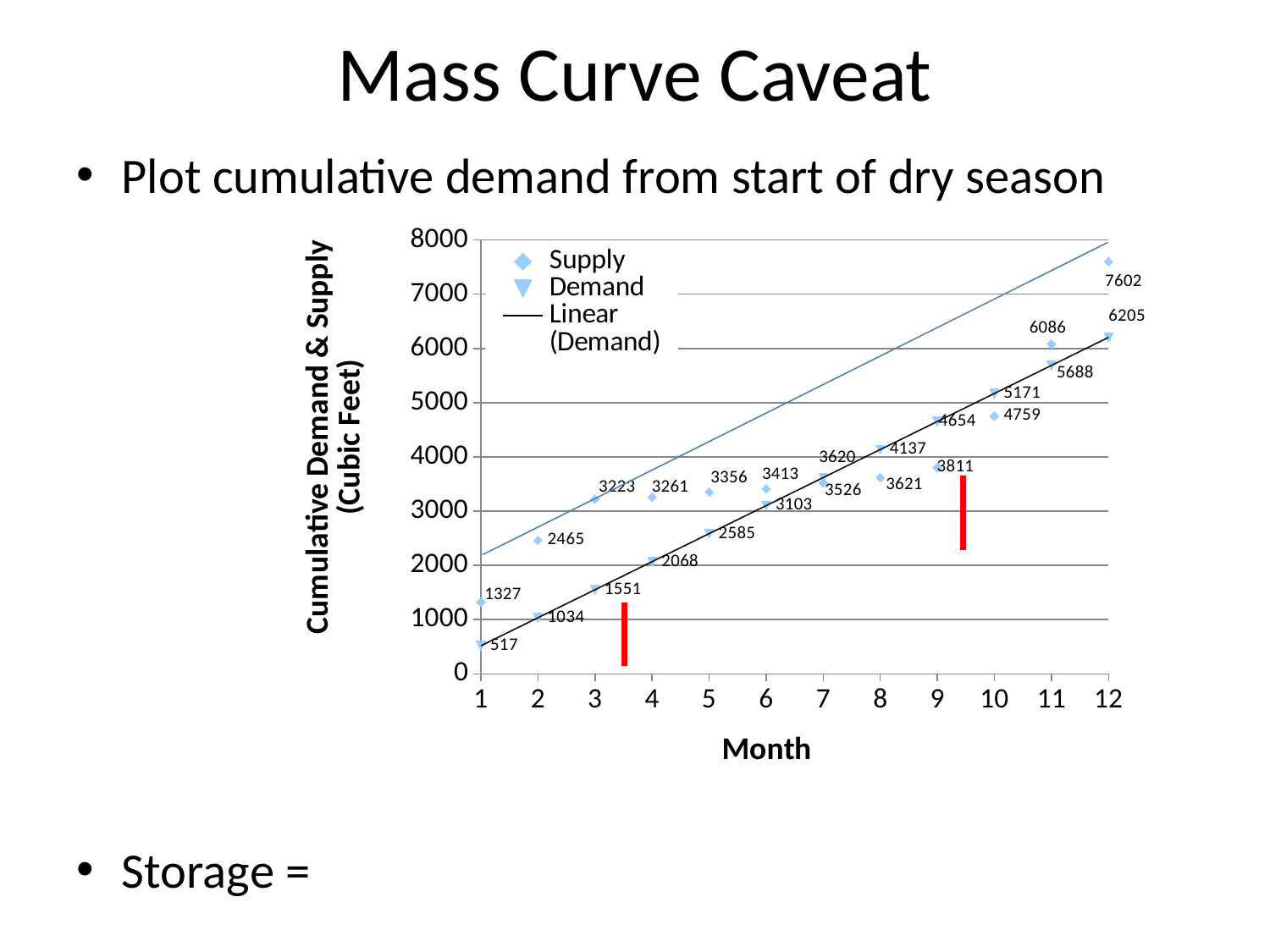
What is the cumulative Supply value at month 2? 2465 At which month is the cumulative Supply highest? 12 How many entries does the legend list? 3 Is the Supply value at month 10 greater or less than 5000? less What is the cumulative Demand value at month 1? 517 Does the cumulative Demand rise or fall from month 1 to month 12? rise At which month is the cumulative Demand lowest? 1 How many months are plotted on the x axis? 12 At month 9, which is larger, Supply or Demand? Demand What is the difference between Supply and Demand at month 12? 1397 What is the cumulative Supply value at month 12? 7602 What is the cumulative Demand value at month 8? 4137